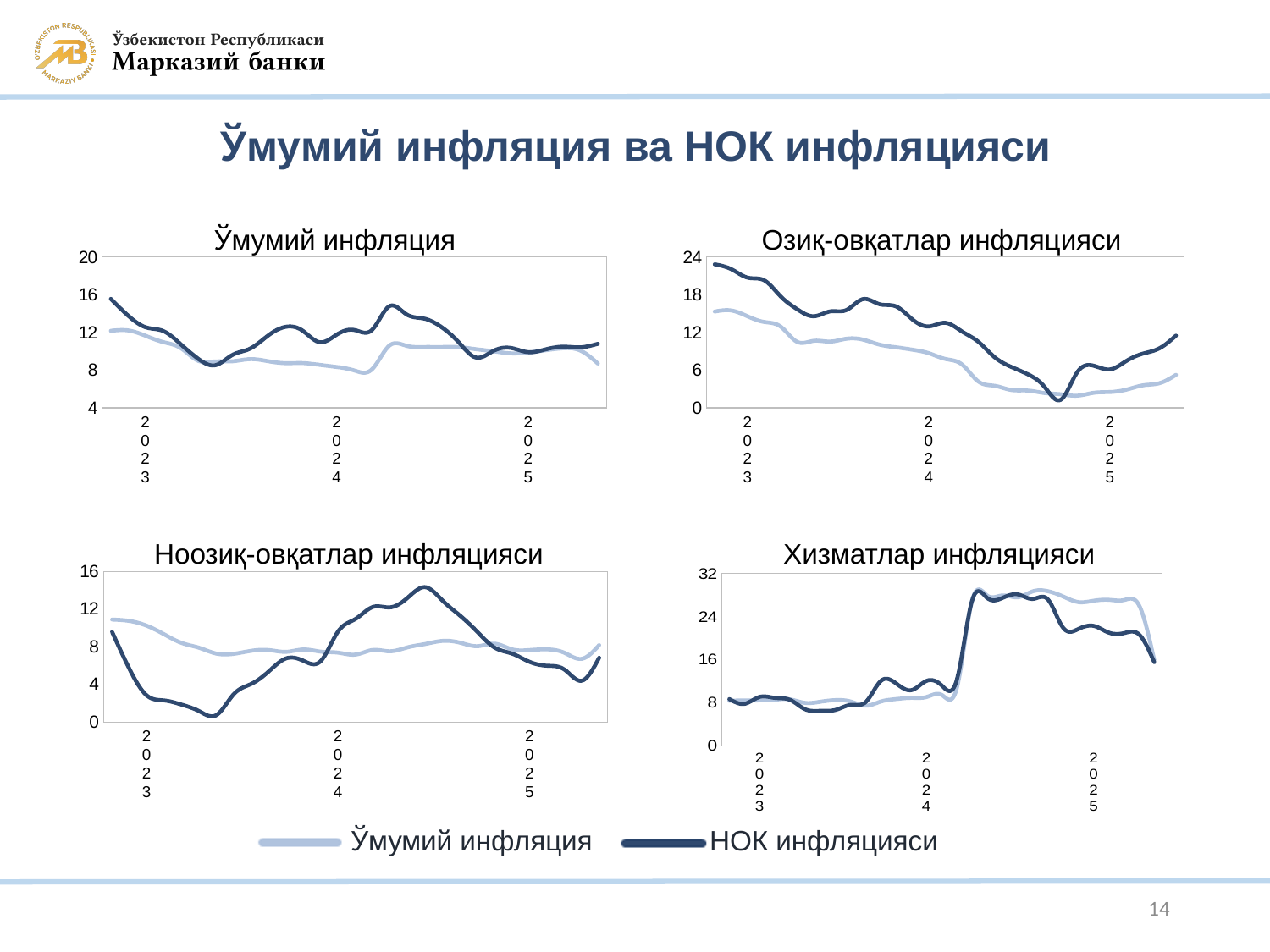
How many year labels are shown on the x axis of the 'Хизматлар инфляцияси' chart? 3 In the 'Ноозиқ-овқатлар инфляцияси' chart, is the value for Ўмумий инфляция at the start of 2023 greater or less than 8? greater What kind of chart is the 'Ўмумий инфляция' chart at the top left? line chart In the 'Ўмумий инфляция' chart, is the value for НОК инфляцияси at the start of 2023 greater or less than 12? greater In the 'Озиқ-овқатлар инфляцияси' chart, does the Ўмумий инфляция line rise or fall from the start of 2023 to the start of 2024? fall In the 'Хизматлар инфляцияси' chart, is the value for Ўмумий инфляция at the start of 2025 greater or less than 24? greater What are the two series named in the legend? Ўмумий инфляция and НОК инфляцияси In the 'Озиқ-овқатлар инфляцияси' chart, which series is higher at the start of 2023, Ўмумий инфляция or НОК инфляцияси? НОК инфляцияси How many series does the legend at the bottom of the slide list? 2 In the 'Ноозиқ-овқатлар инфляцияси' chart, which series is higher at the start of 2023, Ўмумий инфляция or НОК инфляцияси? Ўмумий инфляция